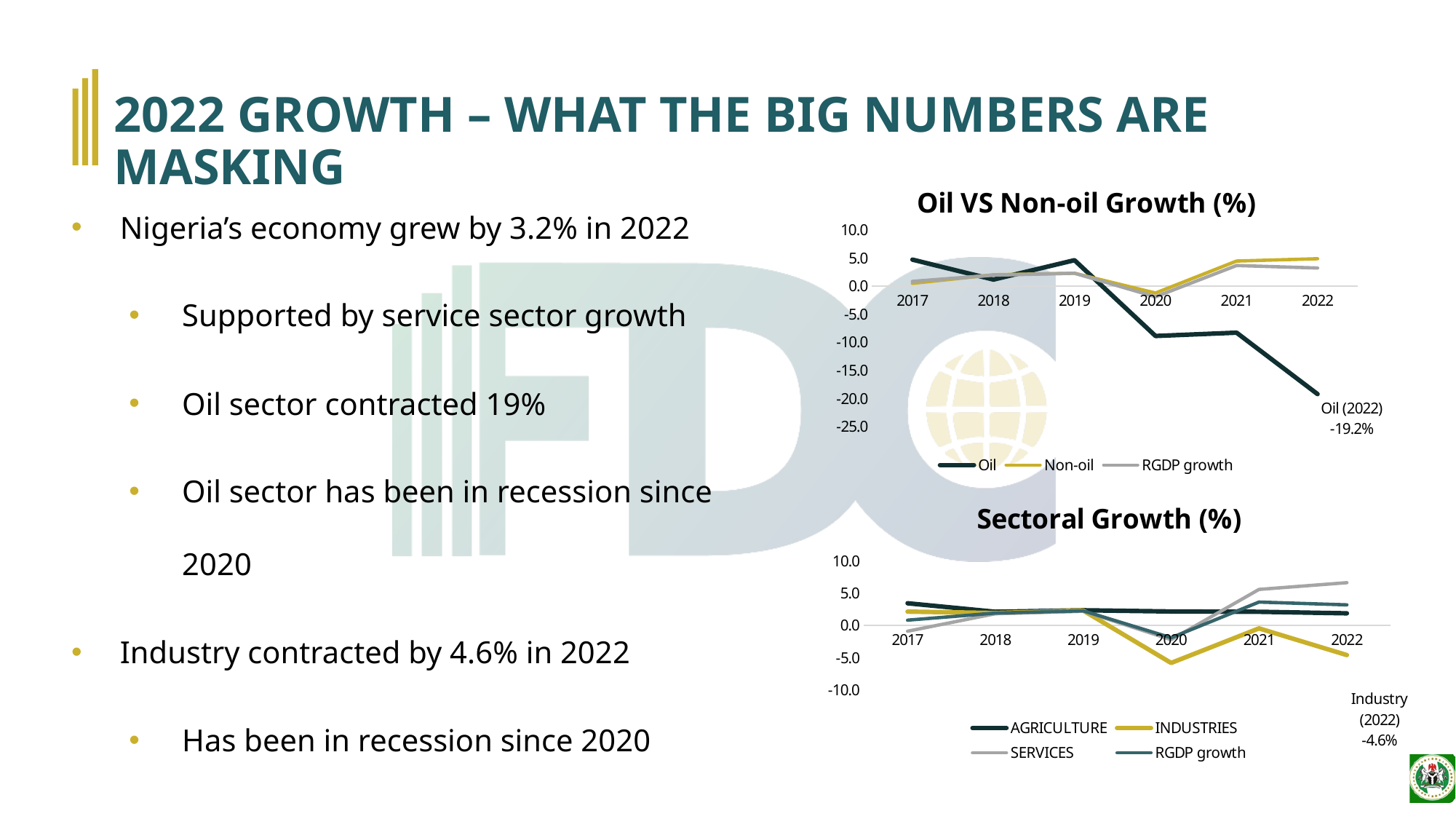
What kind of chart is the 'Oil VS Non-oil Growth (%)' chart? line chart In the 'Oil VS Non-oil Growth (%)' chart, in which year is the Oil series at its lowest? 2022 In the 'Oil VS Non-oil Growth (%)' chart, which is larger in 2022, Oil or Non-oil? Non-oil In the 'Oil VS Non-oil Growth (%)' chart, what is the Oil growth value for 2022? -19.2% How many series does the legend of the 'Sectoral Growth (%)' chart list? 4 In the 'Sectoral Growth (%)' chart, which series has the highest value in 2022? SERVICES How many series does the legend of the 'Oil VS Non-oil Growth (%)' chart list? 3 In the 'Oil VS Non-oil Growth (%)' chart, is the Non-oil value for 2022 greater or less than 0.0? greater In the 'Oil VS Non-oil Growth (%)' chart, does the Oil series rise or fall from 2019 to 2022? fall How many years are shown on the x axis of the 'Sectoral Growth (%)' chart? 6 In the 'Sectoral Growth (%)' chart, is the INDUSTRIES value for 2020 greater or less than 0.0? less In the 'Sectoral Growth (%)' chart, what is the Industry growth value for 2022? -4.6%